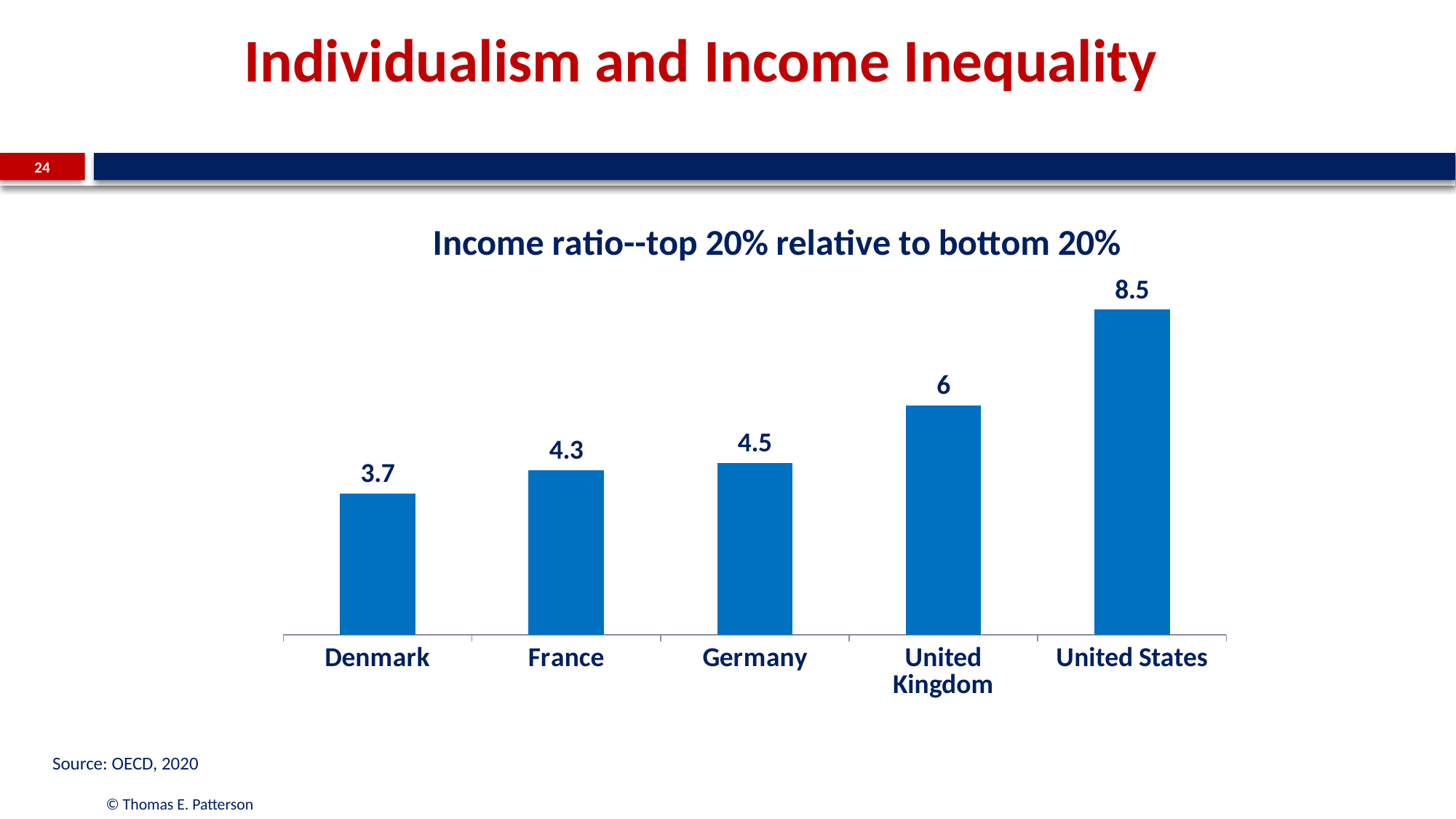
What is the income ratio for the United States? 8.5 What is the income ratio for Denmark? 3.7 Which country has the lowest income ratio? Denmark Which has a larger income ratio, Germany or the United Kingdom? United Kingdom How many countries are shown in the chart? 5 What is the title of the chart? Income ratio--top 20% relative to bottom 20% What is the income ratio for the United Kingdom? 6 What is the difference between the income ratio of the United States and that of Denmark? 4.8 What is the income ratio for Germany? 4.5 What kind of chart is shown on the slide? Bar chart Which country has the highest income ratio? United States What is the difference between the income ratio of the United Kingdom and that of France? 1.7